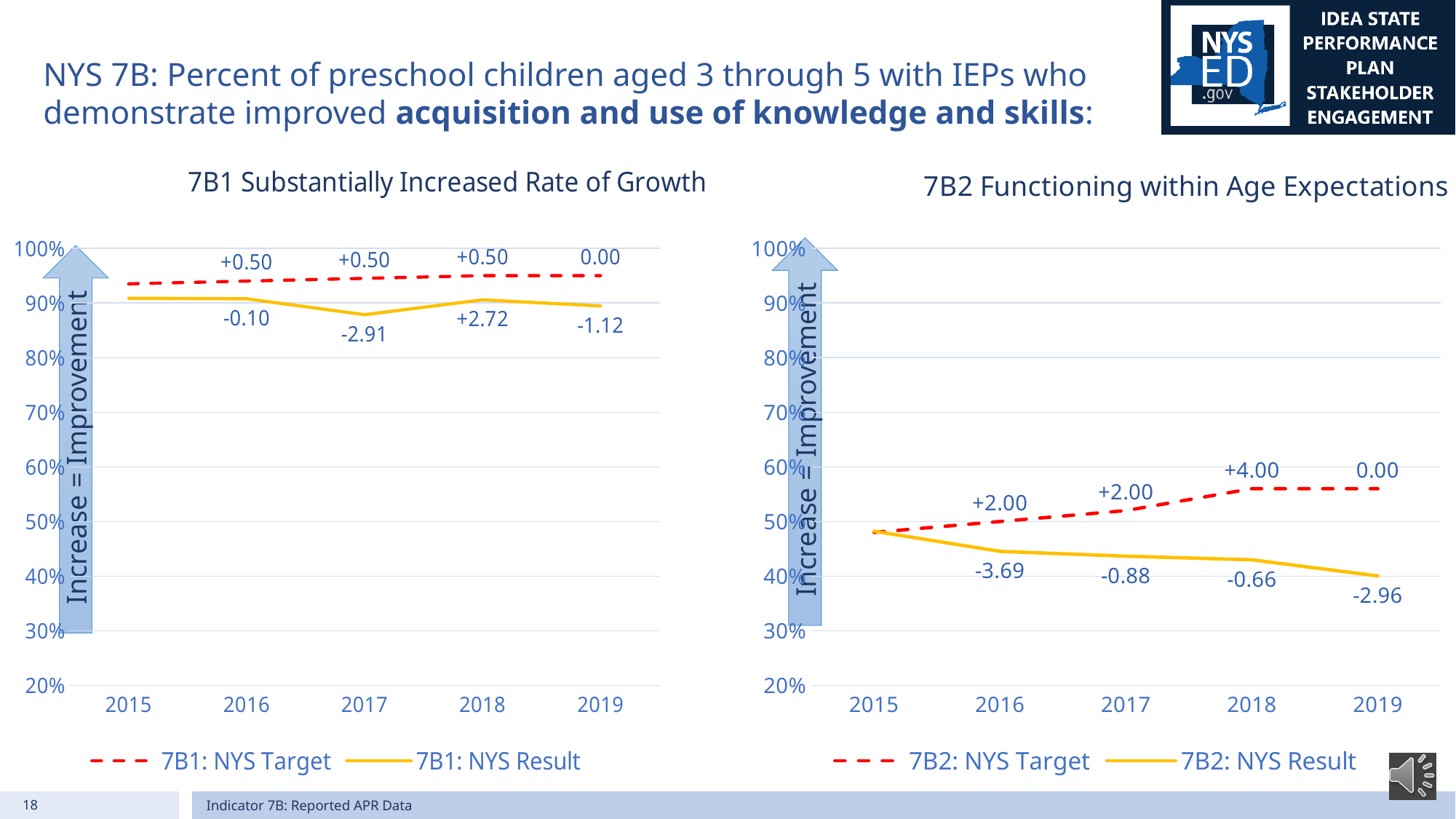
In the 7B2 Functioning within Age Expectations chart, what change label is shown for the 7B2: NYS Target in 2018? +4.00 In the 7B2 Functioning within Age Expectations chart, which is larger in 2019, the 7B2: NYS Target or the 7B2: NYS Result? 7B2: NYS Target In the 7B1 Substantially Increased Rate of Growth chart, what change label is shown for the 7B1: NYS Result in 2018? +2.72 How many years are plotted along the x axis of the 7B1 Substantially Increased Rate of Growth chart? 5 In the 7B2 Functioning within Age Expectations chart, does the 7B2: NYS Result line rise or fall from 2015 to 2019? fall In the 7B1 Substantially Increased Rate of Growth chart, what change label is shown for the 7B1: NYS Result in 2017? -2.91 In the 7B1 Substantially Increased Rate of Growth chart, is the 7B1: NYS Result value for 2017 greater or less than 90%? less What type of chart is the 7B1 Substantially Increased Rate of Growth chart? line chart In the 7B2 Functioning within Age Expectations chart, what change label is shown for the 7B2: NYS Result in 2016? -3.69 In the 7B2 Functioning within Age Expectations chart, does the 7B2: NYS Target line rise or fall from 2015 to 2018? rise In the 7B2 Functioning within Age Expectations chart, is the 7B2: NYS Target value for 2018 greater or less than 50%? greater In the 7B2 Functioning within Age Expectations chart, how many series does the legend list? 2